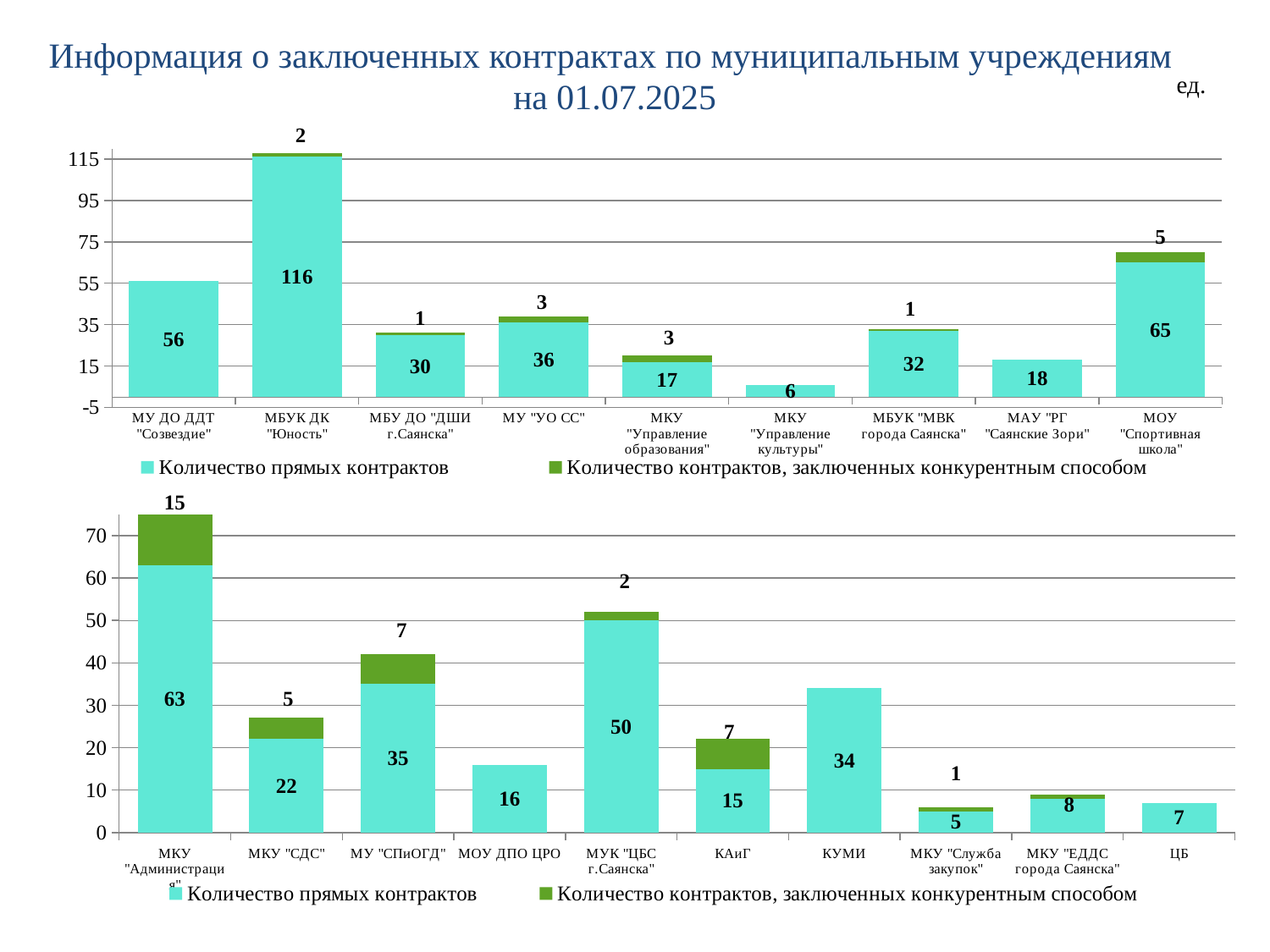
In the bottom chart, what is the total number of contracts (both series) for КАиГ? 22 In the bottom chart, how many contracts concluded by competitive method does МКУ "Администрация" have? 15 In the bottom chart, what is the difference in direct contracts between МУК "ЦБС г.Саянска" and КУМИ? 16 In the top chart, how many contracts concluded by competitive method does МОУ "Спортивная школа" have? 5 In the bottom chart, which has more direct contracts: МУ "СПиОГД" or МКУ "СДС"? МУ "СПиОГД" In the top chart, which institution has the lowest number of direct contracts? МКУ "Управление культуры" In the top chart, what is the total number of contracts (both series) for МУ "УО СС"? 39 What type of chart is the top chart? Stacked bar chart How many series does the legend of the bottom chart list? 2 In the top chart, how many direct contracts (Количество прямых контрактов) does МБУК ДК "Юность" have? 116 In the top chart, how many institutions (categories) are shown? 9 In the bottom chart, which institution has the highest number of direct contracts? МКУ "Администрация"